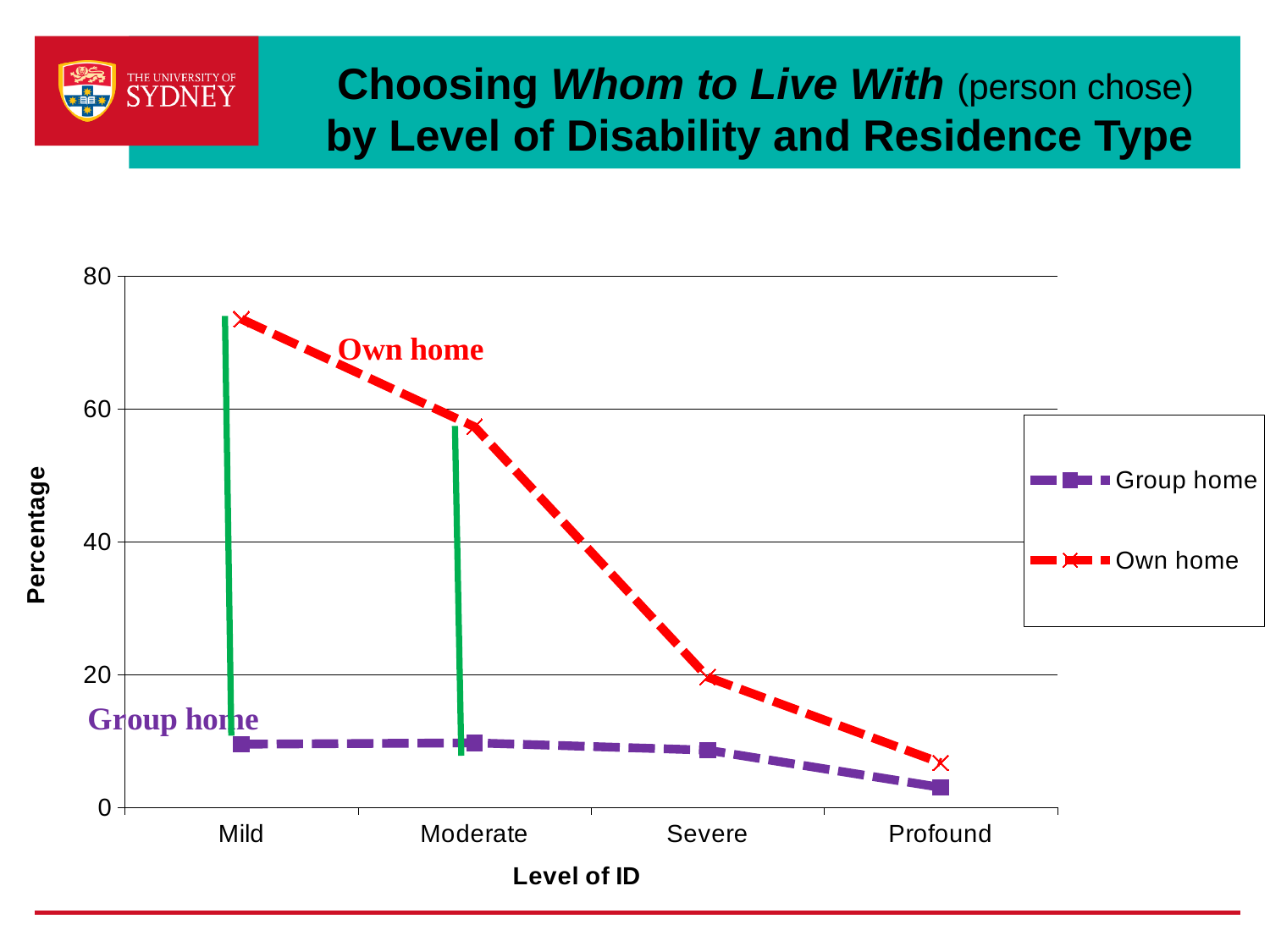
Is the Group home value for Mild greater or less than 20? less What is the title of the x axis? Level of ID Does the Own home series rise or fall from Mild to Profound? fall Which series has the larger value at Moderate, Group home or Own home? Own home Is the Own home value for Mild greater or less than 60? greater How many series does the legend list? 2 At which level of ID is the Group home series lowest? Profound At which level of ID is the Own home series highest? Mild Is the Own home value for Profound greater or less than 20? less How many levels of ID are shown on the x axis? 4 At which level of ID is the Own home series lowest? Profound What kind of chart is shown on the slide? line chart